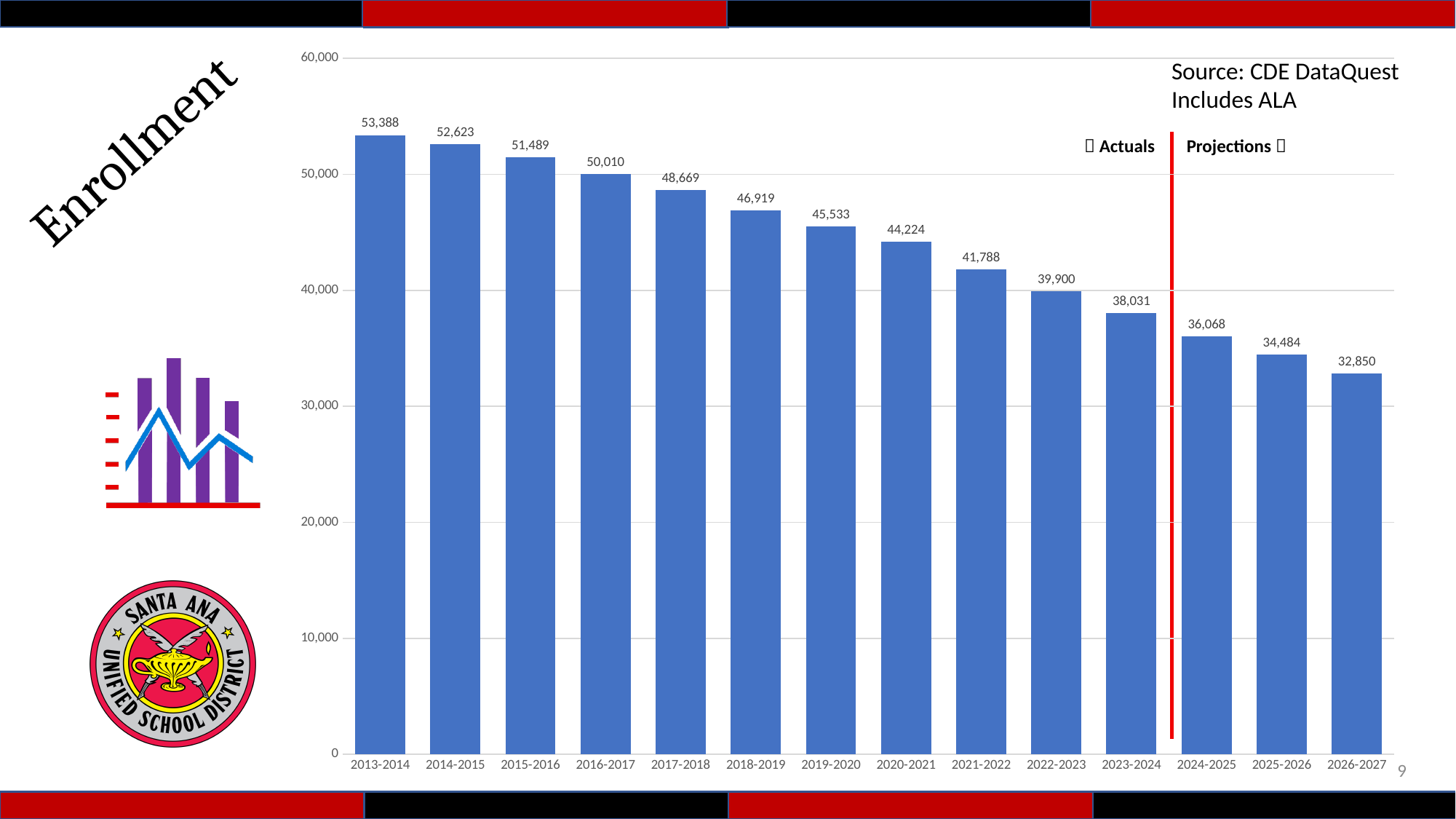
Which school year has the highest enrollment? 2013-2014 What is the difference in enrollment between 2013-2014 and 2023-2024? 15,357 What is the enrollment value for 2023-2024? 38,031 Which school year has the lowest enrollment? 2026-2027 What is the enrollment value for 2013-2014? 53,388 What kind of chart is shown on the slide? Bar chart What is the projected enrollment for 2026-2027? 32,850 Do enrollment values rise or fall from 2013-2014 to 2026-2027? Fall What is the enrollment value for 2019-2020? 45,533 Which is larger, the enrollment for 2016-2017 or for 2020-2021? 2016-2017 What is the source cited for the chart data? CDE DataQuest How many school years are shown on the chart? 14